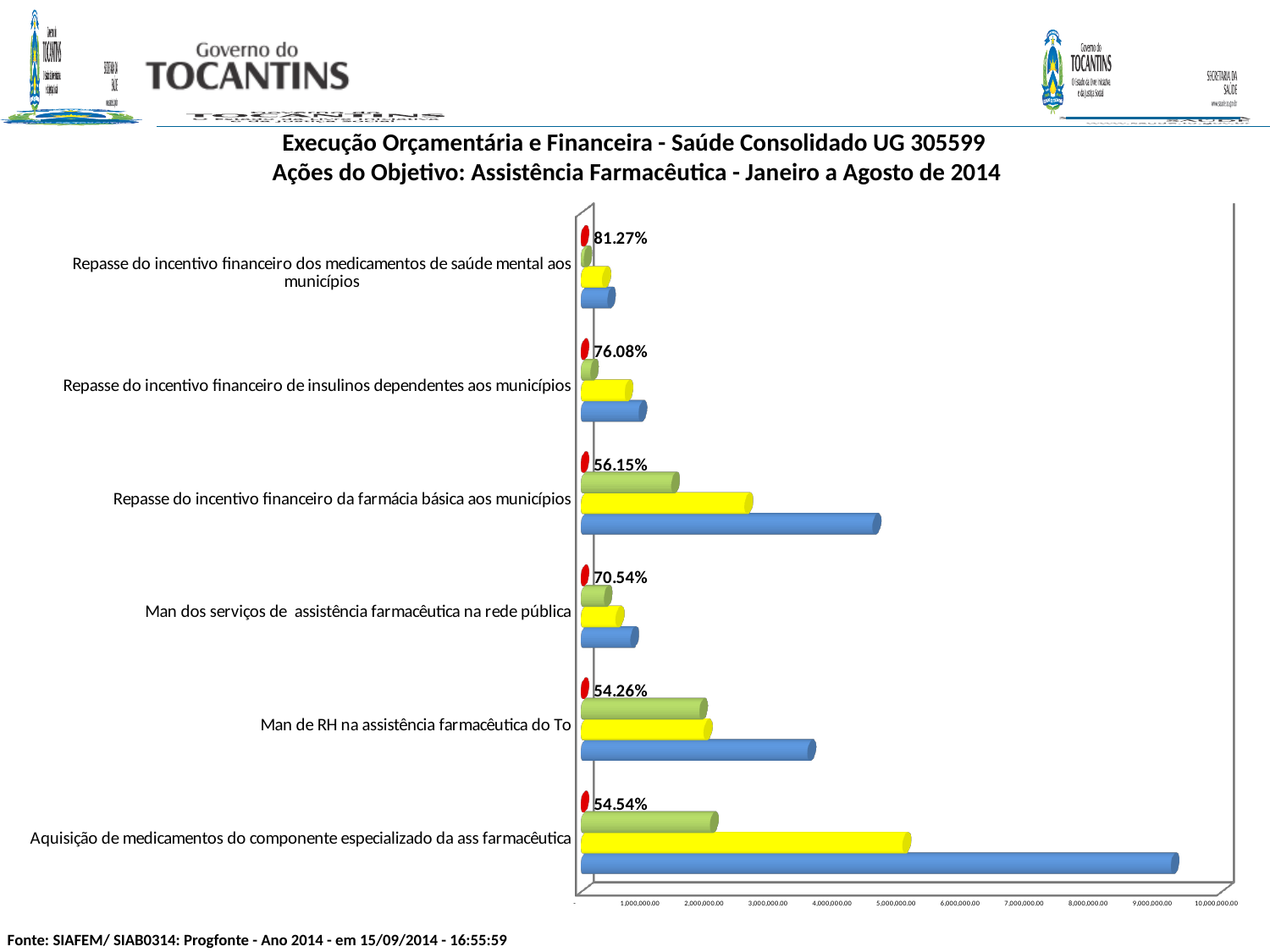
What percentage is shown for "Repasse do incentivo financeiro dos medicamentos de saúde mental aos municípios"? 81.27% Which category has the highest percentage label? Repasse do incentivo financeiro dos medicamentos de saúde mental aos municípios What percentage is shown for "Aquisição de medicamentos do componente especializado da ass farmacêutica"? 54.54% Which category has the longest blue bar? Aquisição de medicamentos do componente especializado da ass farmacêutica What kind of chart is shown on the slide? Bar chart How many categories are shown on the chart? 6 Which category has the lowest percentage label? Man de RH na assistência farmacêutica do To Is the blue bar for "Aquisição de medicamentos do componente especializado da ass farmacêutica" greater or less than 9,000,000.00? greater What percentage is shown for "Repasse do incentivo financeiro da farmácia básica aos municípios"? 56.15% Is the blue bar for "Repasse do incentivo financeiro da farmácia básica aos municípios" greater or less than 5,000,000.00? less Which has the higher percentage label: "Man dos serviços de assistência farmacêutica na rede pública" or "Repasse do incentivo financeiro da farmácia básica aos municípios"? Man dos serviços de assistência farmacêutica na rede pública What is the difference between the percentage for "Repasse do incentivo financeiro dos medicamentos de saúde mental aos municípios" and the percentage for "Repasse do incentivo financeiro de insulinos dependentes aos municípios"? 5.19%